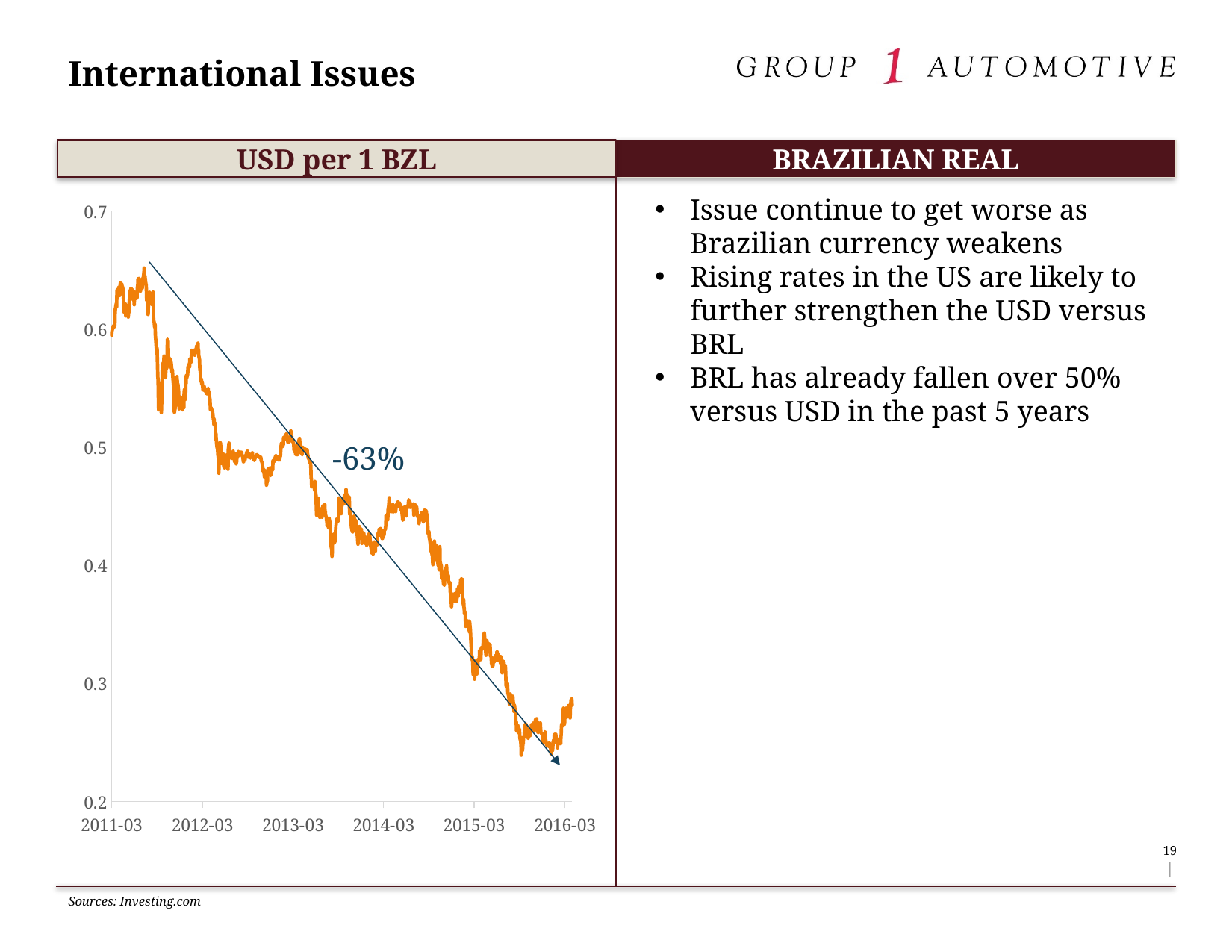
What kind of chart is shown under the heading "USD per 1 BZL"? line chart In the "USD per 1 BZL" chart, is the value at 2014-03 greater or less than 0.6? less In the "USD per 1 BZL" chart, do the values generally rise or fall from 2011-03 to 2016-03? fall In the "USD per 1 BZL" chart, which is higher: the value at 2012-03 or the value at 2015-03? 2012-03 How many date labels are shown on the x axis of the "USD per 1 BZL" chart? 6 What percentage change is annotated on the trend arrow in the "USD per 1 BZL" chart? -63% What is the highest tick value shown on the y axis of the "USD per 1 BZL" chart? 0.7 In the "USD per 1 BZL" chart, is the value at 2016-03 greater or less than 0.4? less What is the first date label on the x axis of the "USD per 1 BZL" chart? 2011-03 In the "USD per 1 BZL" chart, is the value at 2011-03 greater or less than 0.5? greater